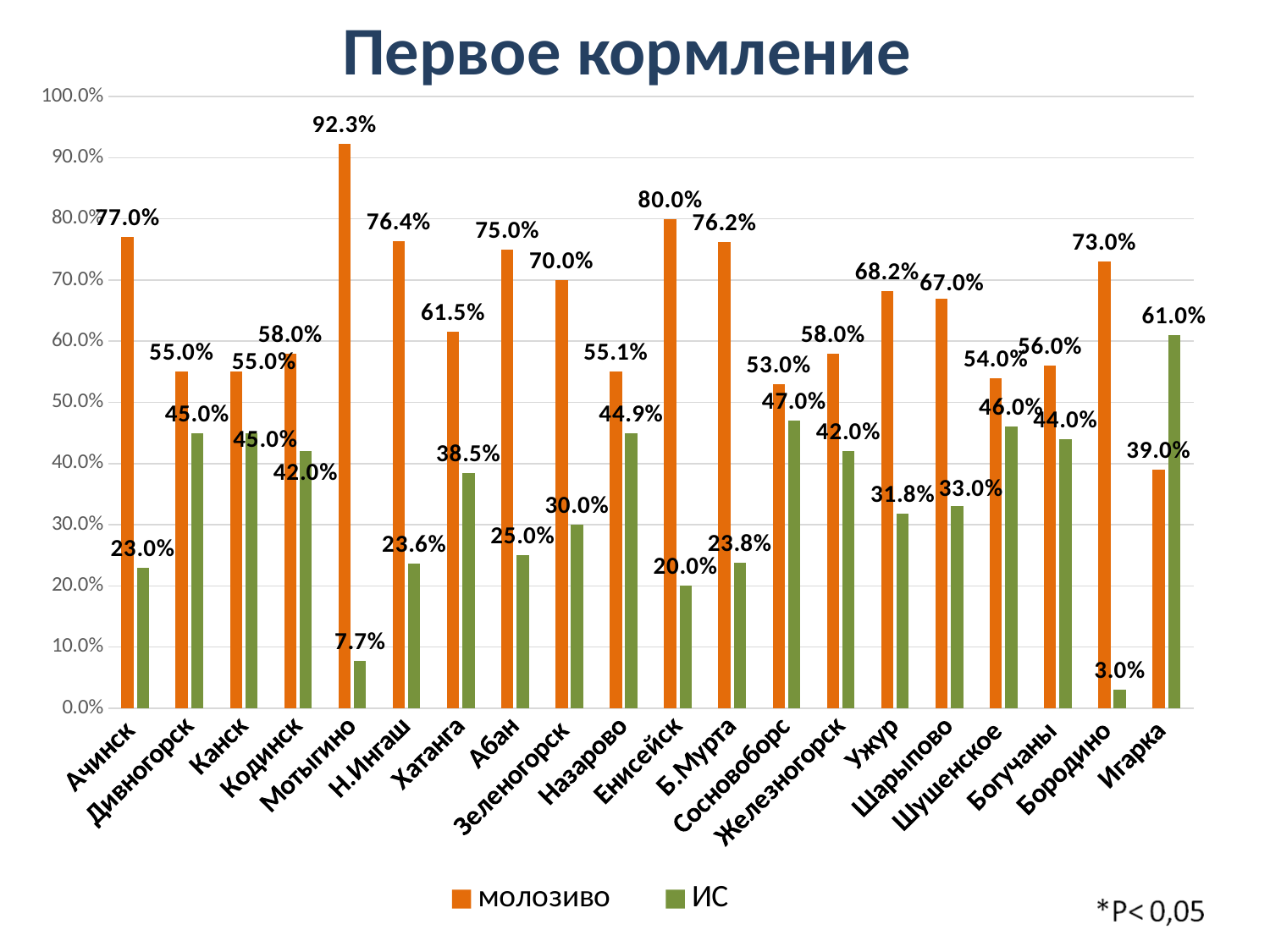
What is the title of the chart? Первое кормление Which category has the lowest ИС value? Бородино Which category has the highest молозиво value? Мотыгино Which category has the lowest молозиво value? Игарка What is the молозиво value for Мотыгино? 92.3% What is the ИС value for Бородино? 3.0% What kind of chart is shown on the slide? Bar chart What is the ИС value for Игарка? 61.0% How many categories are shown on the x axis? 20 What is the difference between the молозиво and ИС values for Енисейск? 60.0% Which is larger for Игарка, the молозиво value or the ИС value? ИС How many series does the legend list? 2